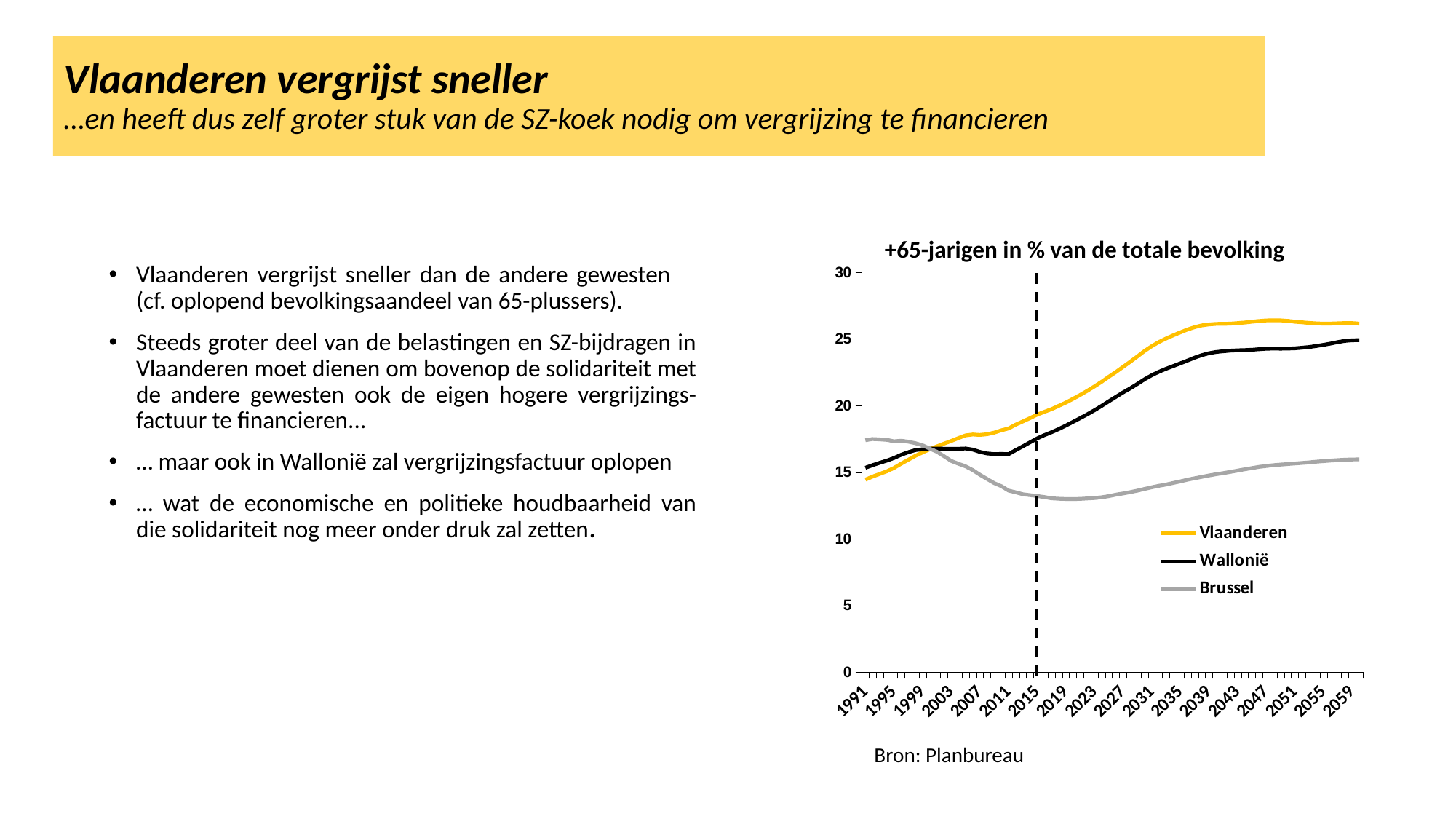
Which colour is used for the Vlaanderen line in the chart? yellow How many series does the legend of the chart list? 3 Is the value for Brussel in 2019 greater or less than 15? less Does the Vlaanderen line rise or fall from 1991 to 2059? rise Is the value for Brussel in 2059 greater or less than 20? less Which series has the lowest value in 2059? Brussel In 1991, which is larger: the value for Brussel or the value for Vlaanderen? Brussel Is the value for Vlaanderen in 2059 greater or less than 25? greater What is the title of the chart? +65-jarigen in % van de totale bevolking What kind of chart is shown on the slide? line chart Which series has the highest value in 2059? Vlaanderen In 2059, which is larger: the value for Vlaanderen or the value for Brussel? Vlaanderen